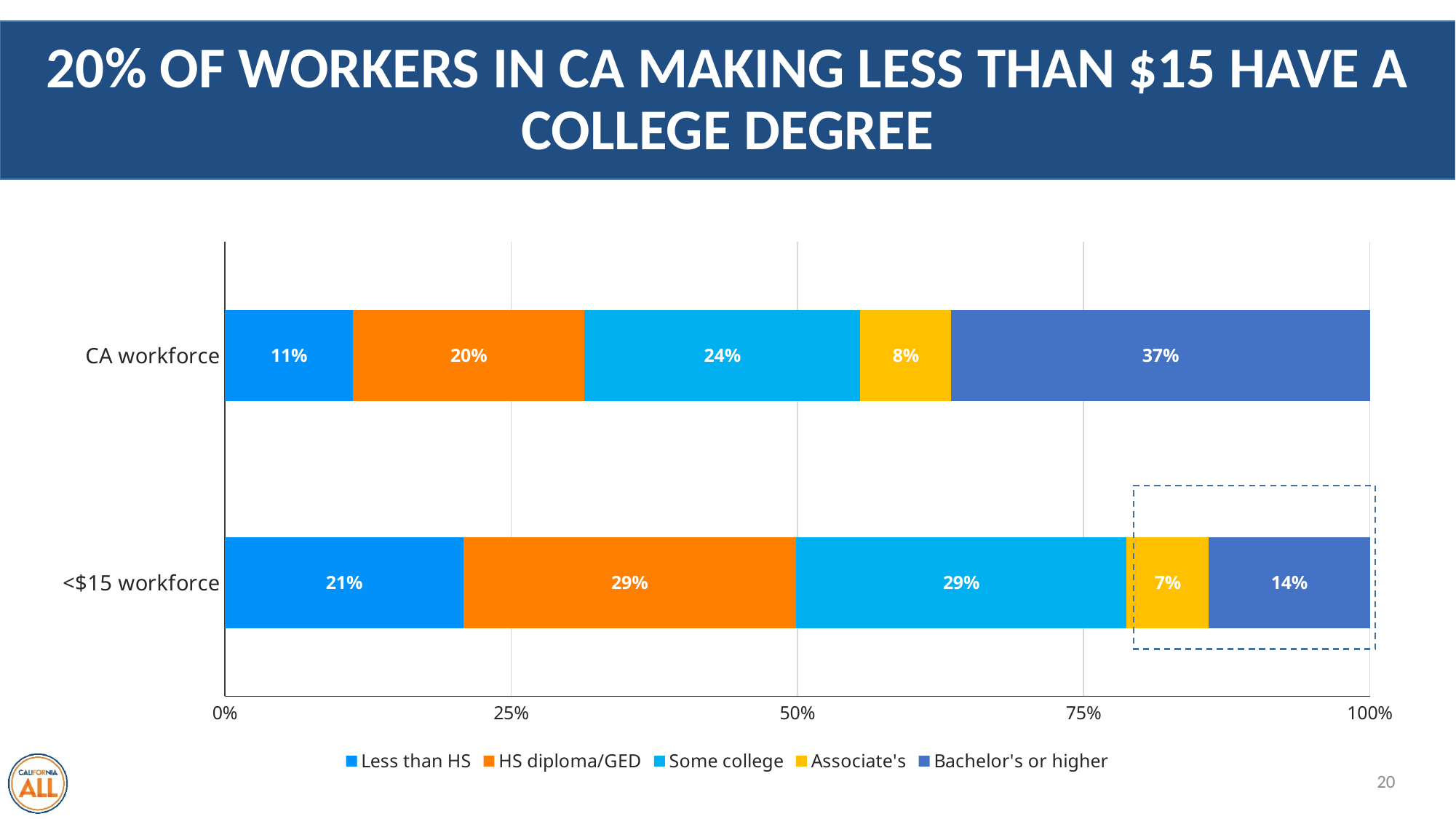
What is the difference between the Bachelor's or higher share of the CA workforce and of the <$15 workforce? 23 percentage points How many series does the legend list? 5 What percentage of the CA workforce has a Bachelor's or higher? 37% Which education category is the smallest share of the <$15 workforce? Associate's What percentage of the <$15 workforce has an Associate's degree? 7% What is the combined share of Associate's and Bachelor's or higher in the <$15 workforce? 21% Which group has a larger share with HS diploma/GED, the CA workforce or the <$15 workforce? <$15 workforce How many workforce groups (bars) are shown in the chart? 2 What kind of chart is shown on the slide? Stacked bar chart What percentage of the CA workforce has some college? 24% Which education category is the largest share of the CA workforce? Bachelor's or higher What percentage of the <$15 workforce has less than HS education? 21%